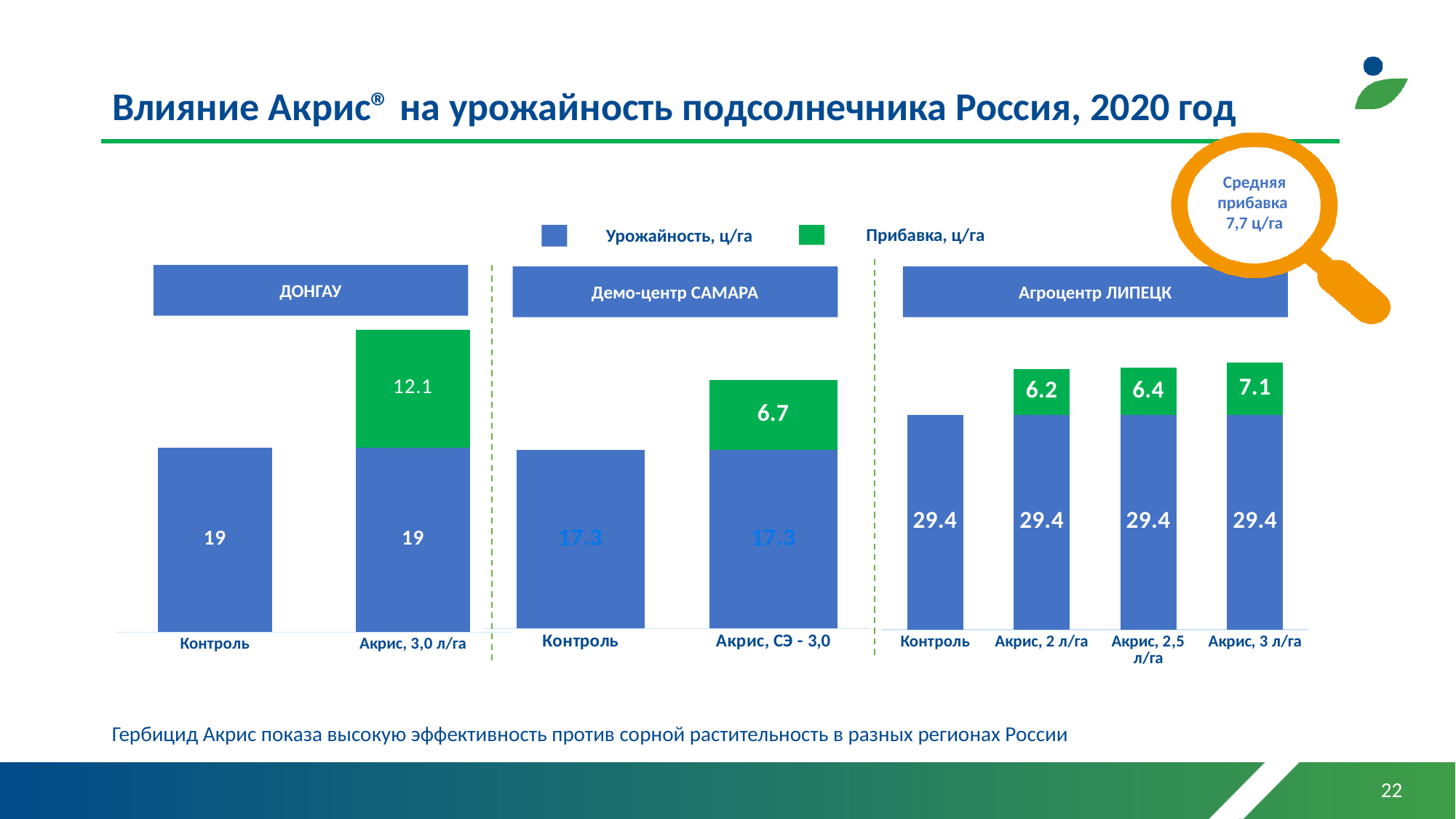
What kind of chart is the ДОНГАУ chart? Stacked bar chart In the Агроцентр ЛИПЕЦК chart, what is the total of the stacked bar for Акрис, 2,5 л/га? 35.8 In the ДОНГАУ chart, what is the total height of the stacked bar for Акрис, 3,0 л/га? 31.1 In the ДОНГАУ chart, what is the Прибавка, ц/га value for Акрис, 3,0 л/га? 12.1 In the Агроцентр ЛИПЕЦК chart, what is the difference between the Прибавка values for Акрис, 3 л/га and Акрис, 2 л/га? 0.9 In the ДОНГАУ chart, what is the Урожайность, ц/га value for Контроль? 19 In the Демо-центр САМАРА chart, what is the total of the stacked bar for Акрис, СЭ - 3,0? 24 In the Агроцентр ЛИПЕЦК chart, which category has the highest Прибавка, ц/га value? Акрис, 3 л/га How many series does the legend list? 2 How many categories are shown in the Агроцентр ЛИПЕЦК chart? 4 Which series is shown in green in the legend? Прибавка, ц/га In the Демо-центр САМАРА chart, what is the Прибавка, ц/га value for Акрис, СЭ - 3,0? 6.7